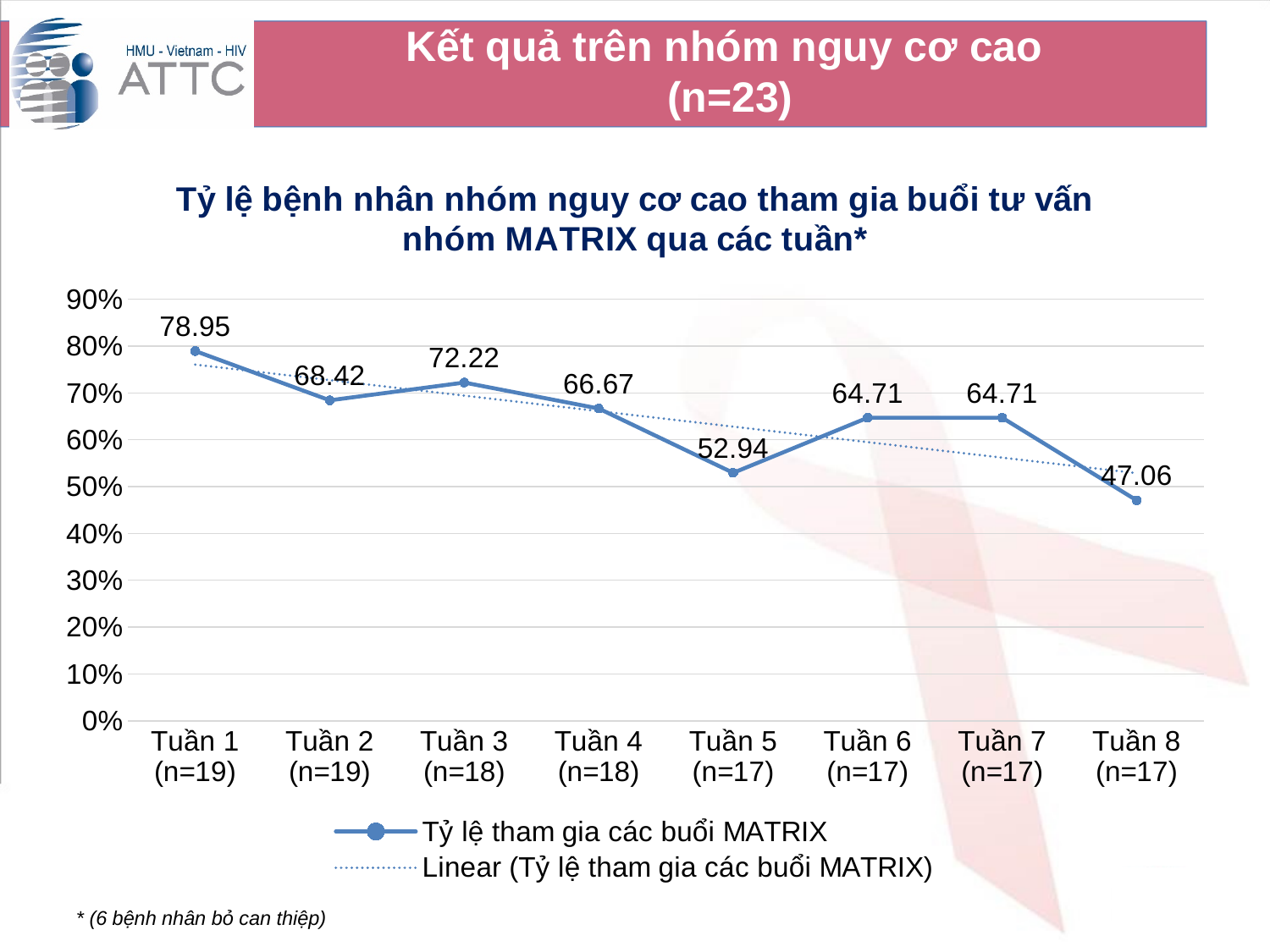
What is the value for Tuần 1 (n=19)? 78.95 What is the difference between the values for Tuần 1 and Tuần 8? 31.89 Which is larger, the value for Tuần 3 or the value for Tuần 4? Tuần 3 Is the value for Tuần 5 greater or less than 60%? less How many weeks are plotted on the x axis? 8 Do the values generally rise or fall from Tuần 1 to Tuần 8? fall Which week has the highest value? Tuần 1 (n=19) What is the value for Tuần 5 (n=17)? 52.94 What is the value for Tuần 8 (n=17)? 47.06 Which week has the lowest value? Tuần 8 (n=17) How many entries does the legend list? 2 What kind of chart is shown? line chart